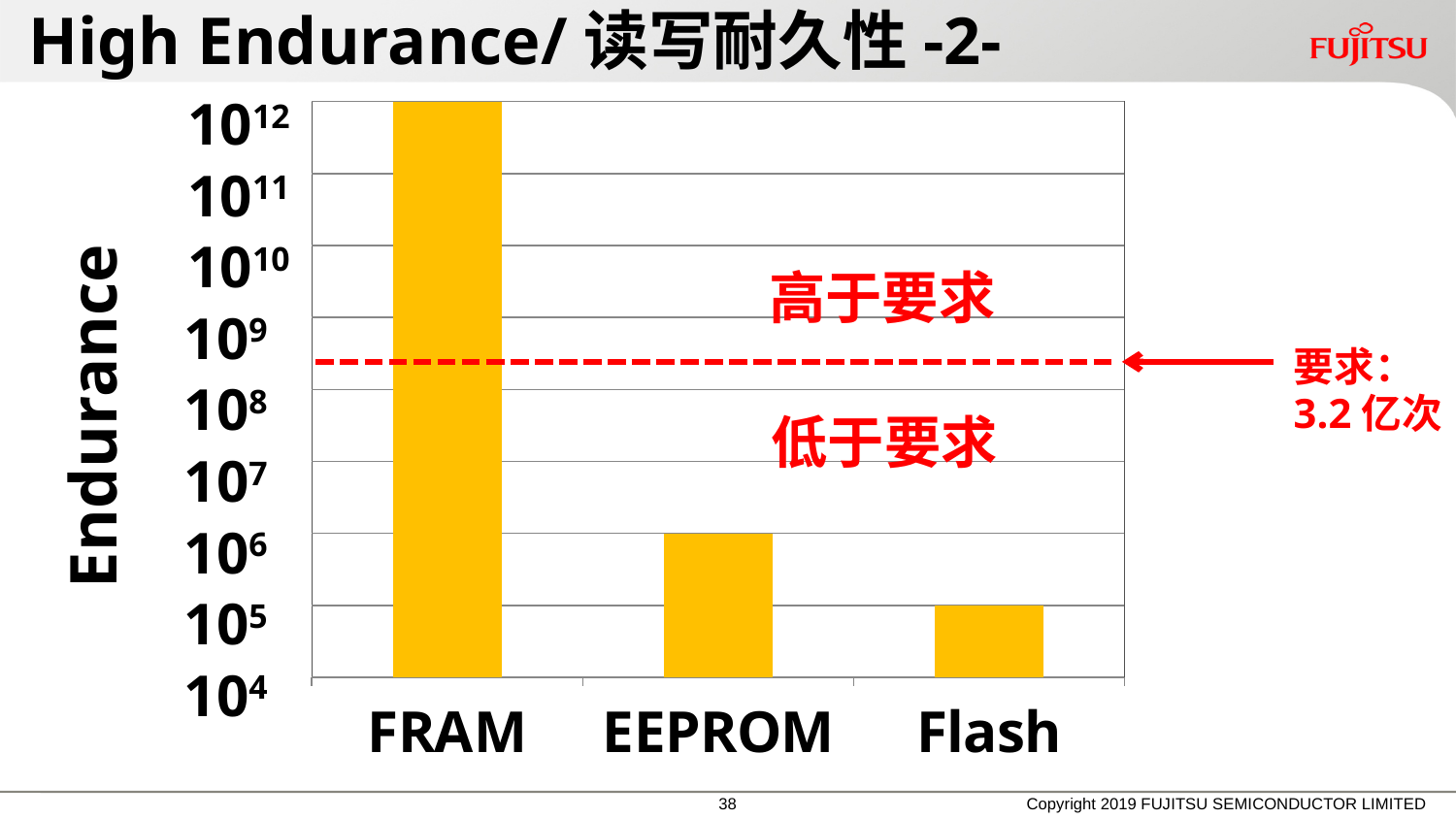
How many memory types are plotted on the x axis? 3 Is the endurance value for EEPROM greater or less than 10⁸? less What endurance value does the FRAM bar reach? 10¹² Which memory type has the highest endurance? FRAM What kind of chart is shown on the slide? bar chart Is the endurance value for FRAM greater or less than 10⁹? greater What endurance value does the Flash bar reach? 10⁵ What is the label on the y axis of the chart? Endurance Which memory type has the lowest endurance? Flash What endurance value does the EEPROM bar reach? 10⁶ Which has the higher endurance, EEPROM or Flash? EEPROM What requirement value is marked by the red dashed line on the chart? 3.2 亿次